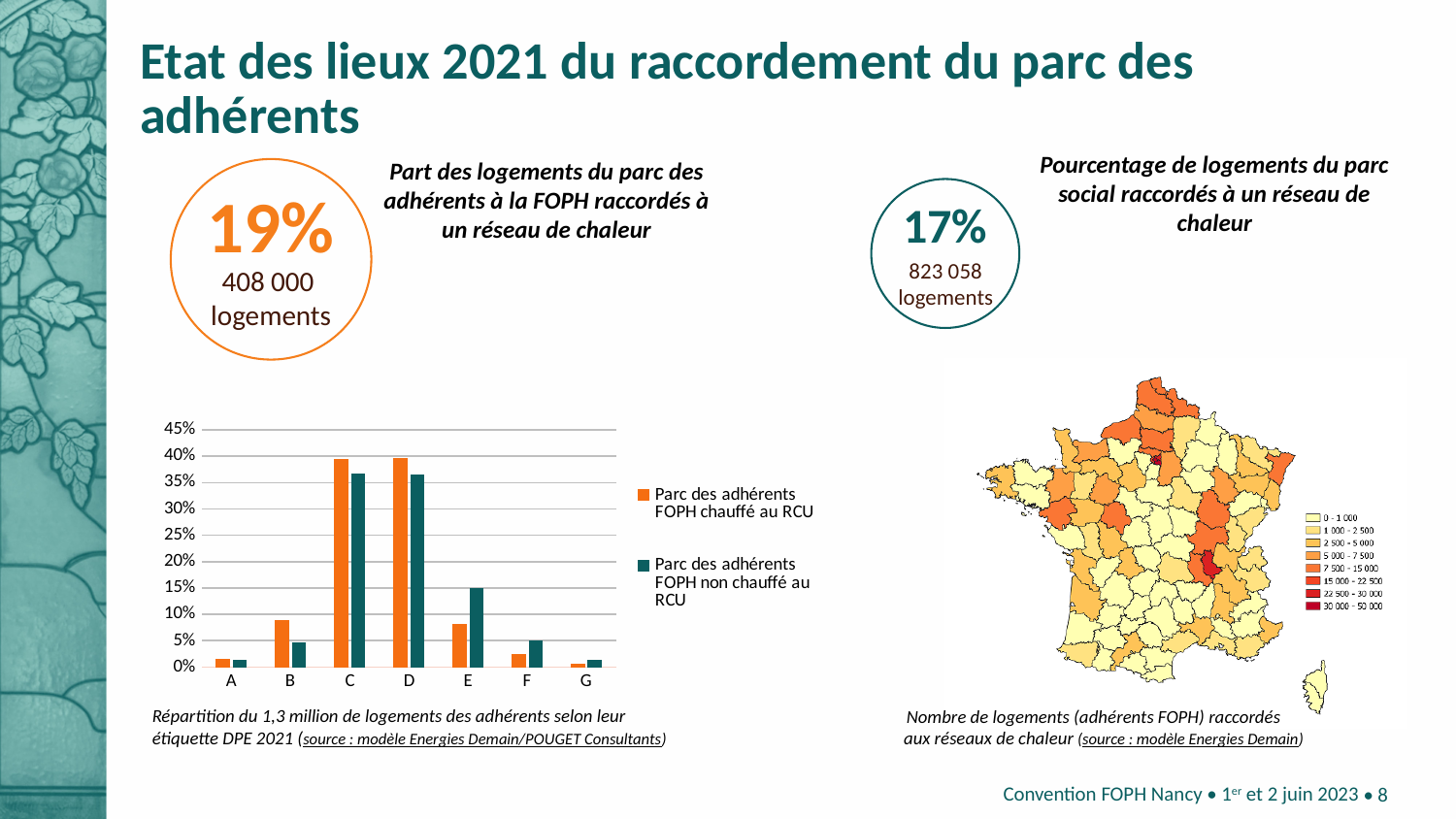
What is the highest value shown on the y axis of the bar chart? 45% How many series does the legend of the bar chart list? 2 Which colour represents the series 'Parc des adhérents FOPH chauffé au RCU' in the bar chart? orange In the bar chart, is the value for category C in the series 'Parc des adhérents FOPH chauffé au RCU' greater or less than 35%? greater In the bar chart, for category B, which series has the larger value: 'Parc des adhérents FOPH chauffé au RCU' or 'Parc des adhérents FOPH non chauffé au RCU'? Parc des adhérents FOPH chauffé au RCU In the bar chart, is the value for category E in the series 'Parc des adhérents FOPH non chauffé au RCU' greater or less than 20%? less In the bar chart, is the value for category B in the series 'Parc des adhérents FOPH chauffé au RCU' greater or less than 10%? less In the bar chart, for category E, which series has the larger value: 'Parc des adhérents FOPH chauffé au RCU' or 'Parc des adhérents FOPH non chauffé au RCU'? Parc des adhérents FOPH non chauffé au RCU What kind of chart is shown at the bottom left of the slide? bar chart In the bar chart, which category has the lowest value for the series 'Parc des adhérents FOPH chauffé au RCU'? G How many categories are shown on the x axis of the bar chart? 7